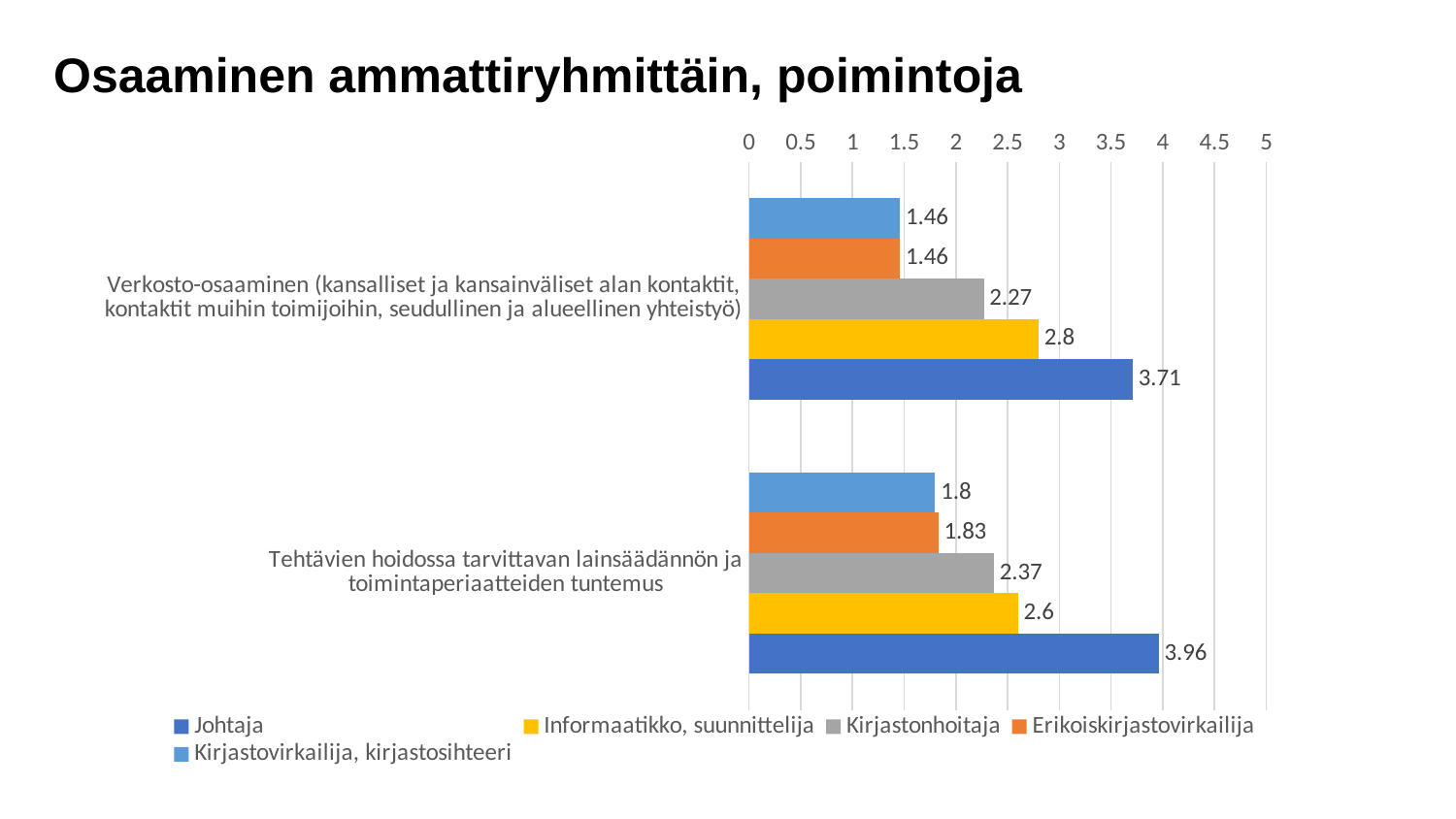
What is the difference between the Johtaja values for the two categories? 0.25 What is the value for Erikoiskirjastovirkailija in the category 'Tehtävien hoidossa tarvittavan lainsäädännön ja toimintaperiaatteiden tuntemus'? 1.83 What kind of chart is shown on the slide? Bar chart Which series has the highest value in the category 'Verkosto-osaaminen'? Johtaja What is the value for Informaatikko, suunnittelija in the category 'Verkosto-osaaminen'? 2.8 What is the difference between the Johtaja value and the Informaatikko, suunnittelija value in the category 'Tehtävien hoidossa tarvittavan lainsäädännön ja toimintaperiaatteiden tuntemus'? 1.36 How many categories are shown on the chart? 2 How many series does the legend list? 5 Which series has the lowest value in the category 'Tehtävien hoidossa tarvittavan lainsäädännön ja toimintaperiaatteiden tuntemus'? Kirjastovirkailija, kirjastosihteeri What is the value for Johtaja in the category 'Tehtävien hoidossa tarvittavan lainsäädännön ja toimintaperiaatteiden tuntemus'? 3.96 What is the value for Kirjastonhoitaja in the category 'Verkosto-osaaminen'? 2.27 Which is larger: the Kirjastonhoitaja value for 'Verkosto-osaaminen' or the Kirjastonhoitaja value for 'Tehtävien hoidossa tarvittavan lainsäädännön ja toimintaperiaatteiden tuntemus'? Tehtävien hoidossa tarvittavan lainsäädännön ja toimintaperiaatteiden tuntemus